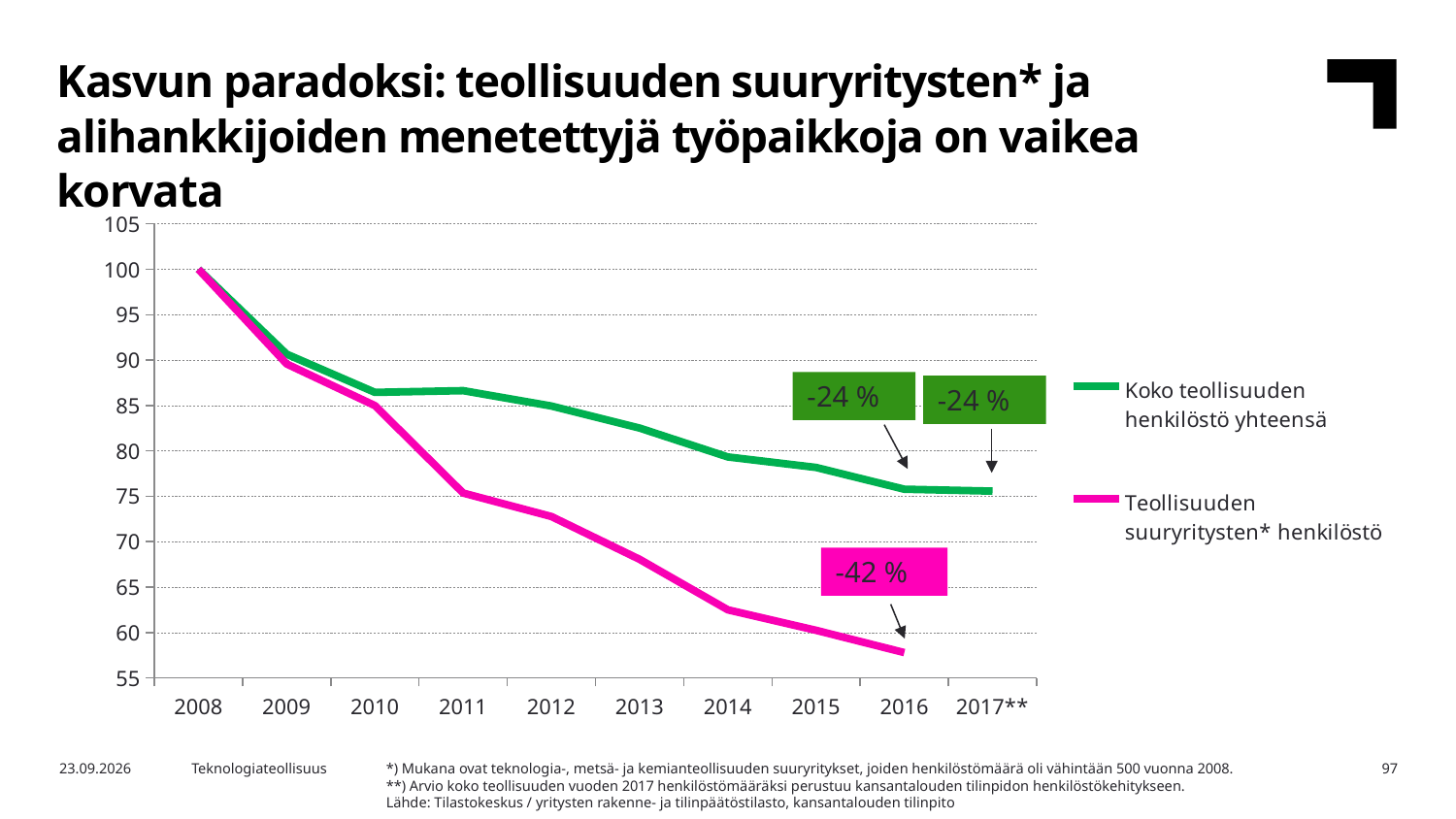
How many years are shown on the x axis? 10 Which series is drawn in green? Koko teollisuuden henkilöstö yhteensä Is the value of the Teollisuuden suuryritysten* henkilöstö series in 2016 greater or less than 60? less In 2016, which series has the higher value: Koko teollisuuden henkilöstö yhteensä or Teollisuuden suuryritysten* henkilöstö? Koko teollisuuden henkilöstö yhteensä What percentage change is labelled for the Teollisuuden suuryritysten* henkilöstö series at 2016? -42 % What percentage change is labelled for the Koko teollisuuden henkilöstö yhteensä series at 2017**? -24 % Is the value of the Koko teollisuuden henkilöstö yhteensä series in 2012 greater or less than 80? greater Do the values of the Teollisuuden suuryritysten* henkilöstö series rise or fall from 2008 to 2016? fall What kind of chart is shown on the slide? line chart What is the value of the Teollisuuden suuryritysten* henkilöstö series in 2008? 100 How many series does the legend list? 2 What is the value of the Koko teollisuuden henkilöstö yhteensä series in 2008? 100